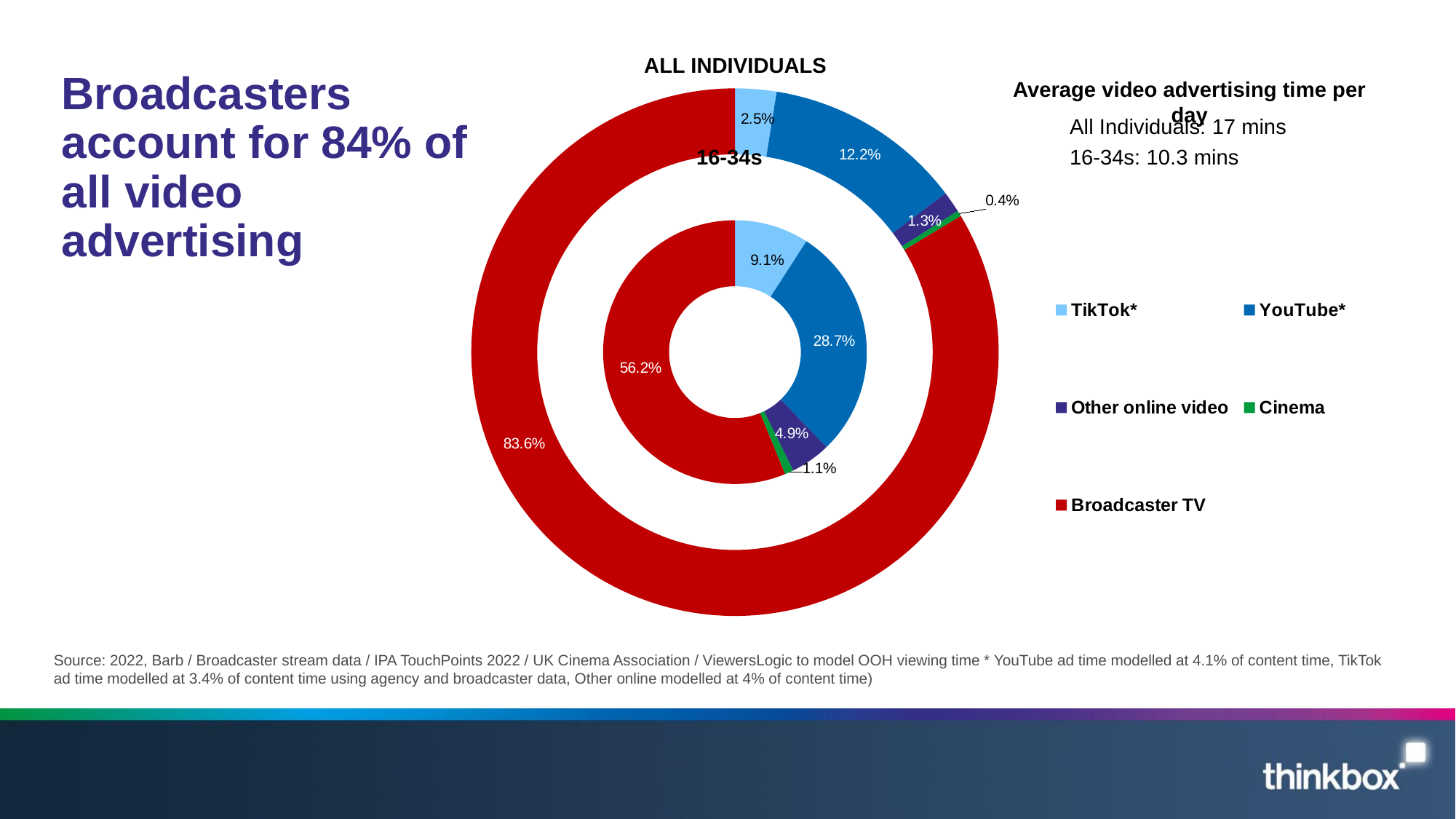
In the ALL INDIVIDUALS ring, what is the value for Cinema? 0.4% In the 16-34s ring, what is the value for Other online video? 4.9% What is the difference between the Broadcaster TV share for ALL INDIVIDUALS and for 16-34s? 27.4 percentage points Which category has the smallest share in the ALL INDIVIDUALS ring? Cinema What is the average video advertising time per day for 16-34s stated on the slide? 10.3 mins Which category has the largest share in the 16-34s ring? Broadcaster TV In the 16-34s ring, what share does YouTube* account for? 28.7% In the 16-34s ring, what is the value for TikTok*? 9.1% How many series does the legend list? 5 In the ALL INDIVIDUALS ring, what share does Broadcaster TV account for? 83.6% Which is larger: the YouTube* share for 16-34s or the YouTube* share for ALL INDIVIDUALS? 16-34s What type of chart is shown on the slide? Doughnut chart